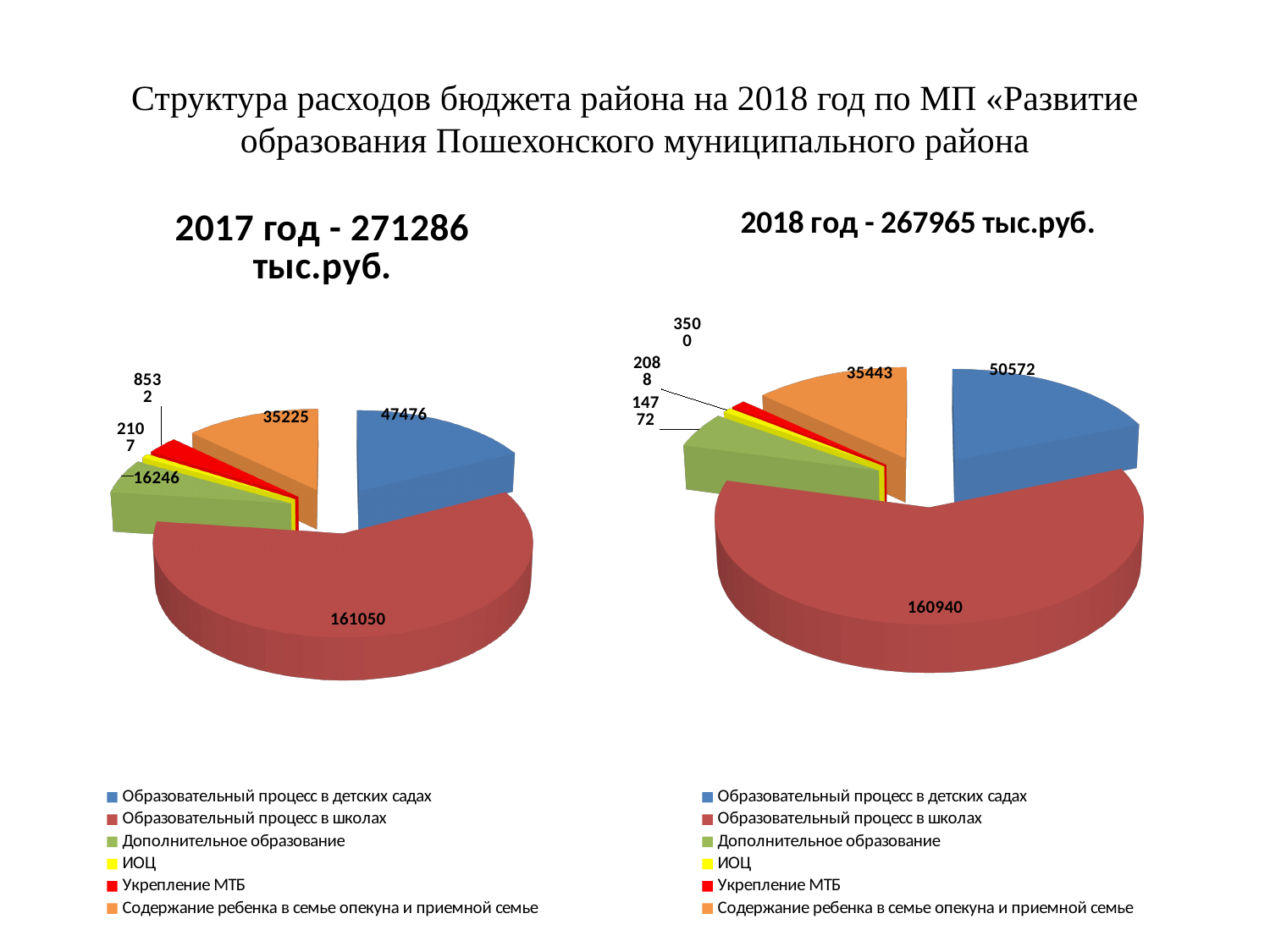
What kind of chart is the chart titled "2017 год - 271286 тыс.руб."? Pie chart How many categories does the legend of the chart titled "2018 год - 267965 тыс.руб." list? 6 In the chart titled "2017 год - 271286 тыс.руб.", what colour is the slice for Укрепление МТБ? Red In the chart titled "2018 год - 267965 тыс.руб.", what is the value for Содержание ребенка в семье опекуна и приемной семье? 35443 In the chart titled "2018 год - 267965 тыс.руб.", which category has the smallest slice? ИОЦ In the chart titled "2017 год - 271286 тыс.руб.", which category has the largest slice? Образовательный процесс в школах In the chart titled "2018 год - 267965 тыс.руб.", what is the difference between Образовательный процесс в школах and Образовательный процесс в детских садах? 110368 In the chart titled "2017 год - 271286 тыс.руб.", which is larger: Образовательный процесс в детских садах or Содержание ребенка в семье опекуна и приемной семье? Образовательный процесс в детских садах How many pie charts are shown on the slide? 2 In the chart titled "2017 год - 271286 тыс.руб.", what is the value for Образовательный процесс в школах? 161050 In the chart titled "2018 год - 267965 тыс.руб.", what is the value for Образовательный процесс в детских садах? 50572 In the chart titled "2017 год - 271286 тыс.руб.", what is the value for Дополнительное образование? 16246